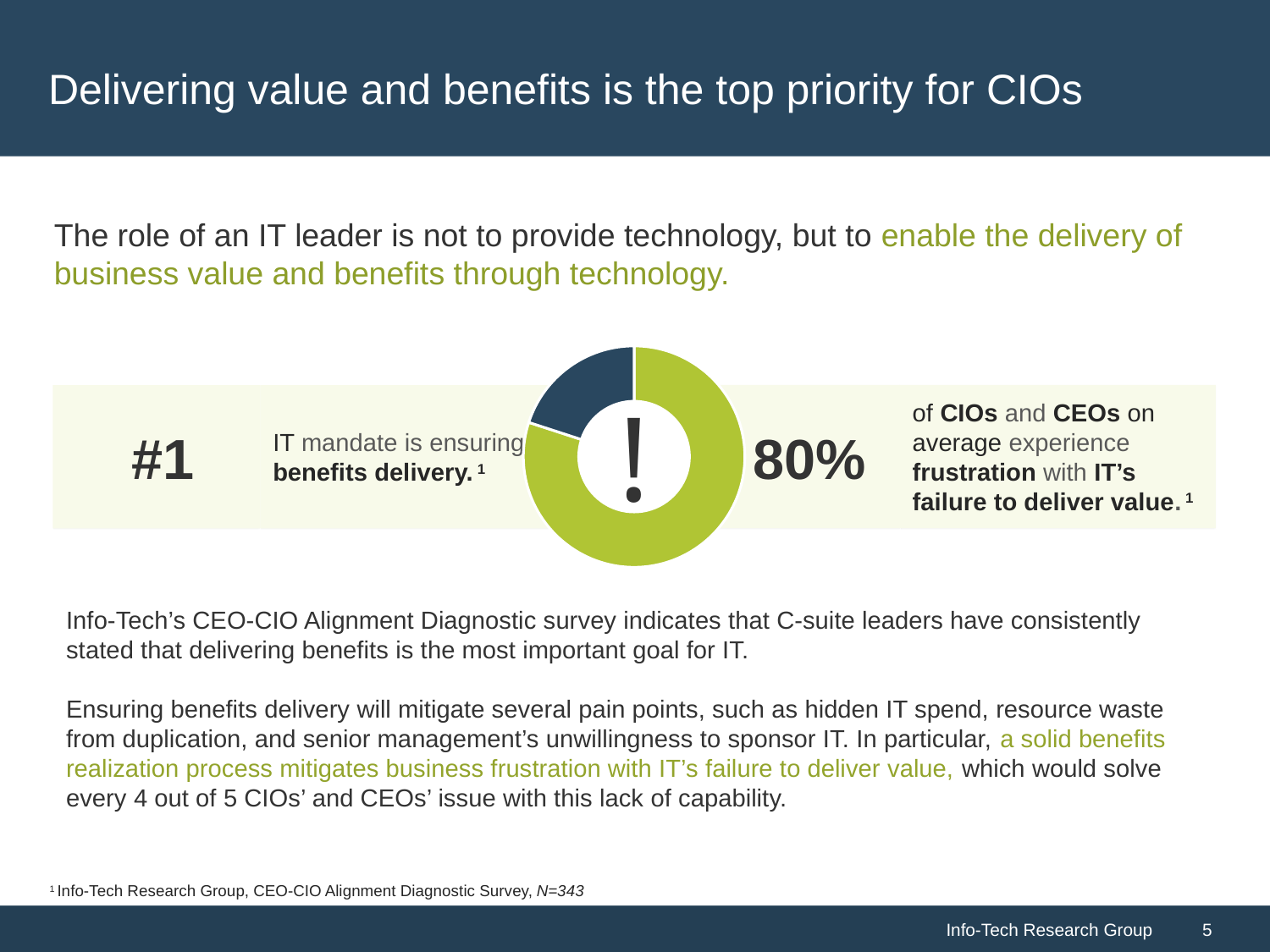
Which slice of the donut chart is larger, the green one or the dark blue one? green What share of the donut chart does the green slice represent? 80% How many slices does the donut chart have? 2 What percentage is printed beside the donut chart? 80% What symbol appears in the centre of the donut chart? ! Is the dark blue slice of the donut chart greater or less than 50%? less What colour is the largest slice of the donut chart? green What kind of chart is shown in the middle of the slide? donut chart